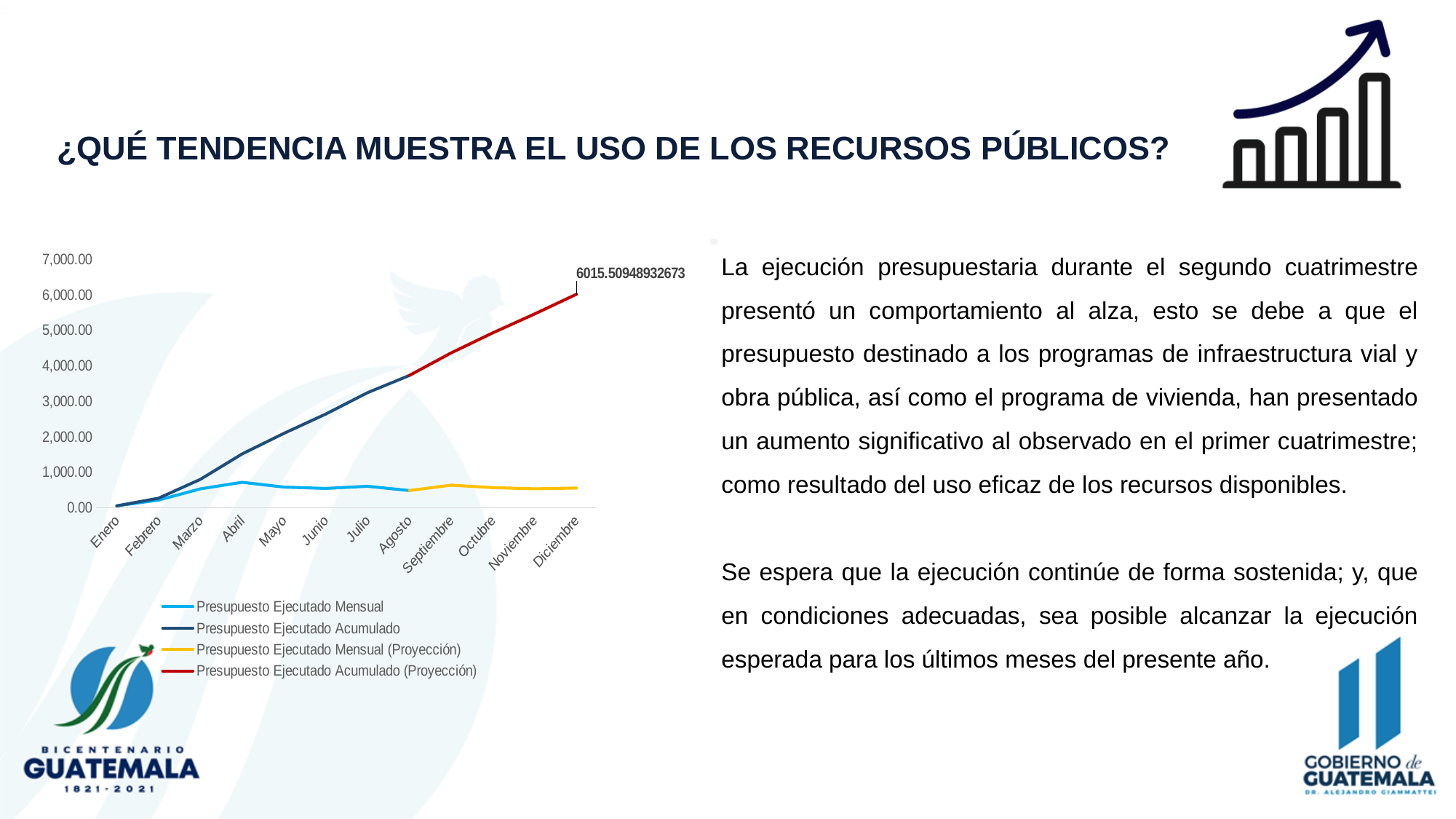
What is the value of Presupuesto Ejecutado Acumulado (Proyección) in Diciembre? 6015.50948932673 How many series does the chart legend list? 4 How many months are shown on the x axis of the chart? 12 In Julio, which is larger: Presupuesto Ejecutado Acumulado or Presupuesto Ejecutado Mensual? Presupuesto Ejecutado Acumulado Does the Presupuesto Ejecutado Acumulado series rise or fall from Enero to Agosto? rise Is the value of Presupuesto Ejecutado Acumulado in Agosto greater or less than 3,000? greater Is the value of Presupuesto Ejecutado Mensual in Abril greater or less than 1,000? less Which series is drawn in yellow on the chart? Presupuesto Ejecutado Mensual (Proyección) What kind of chart is shown on the slide? line chart Is the value of Presupuesto Ejecutado Acumulado (Proyección) in Octubre greater or less than 4,000? greater Which series is drawn in red on the chart? Presupuesto Ejecutado Acumulado (Proyección) In which month does Presupuesto Ejecutado Acumulado (Proyección) reach its highest value? Diciembre